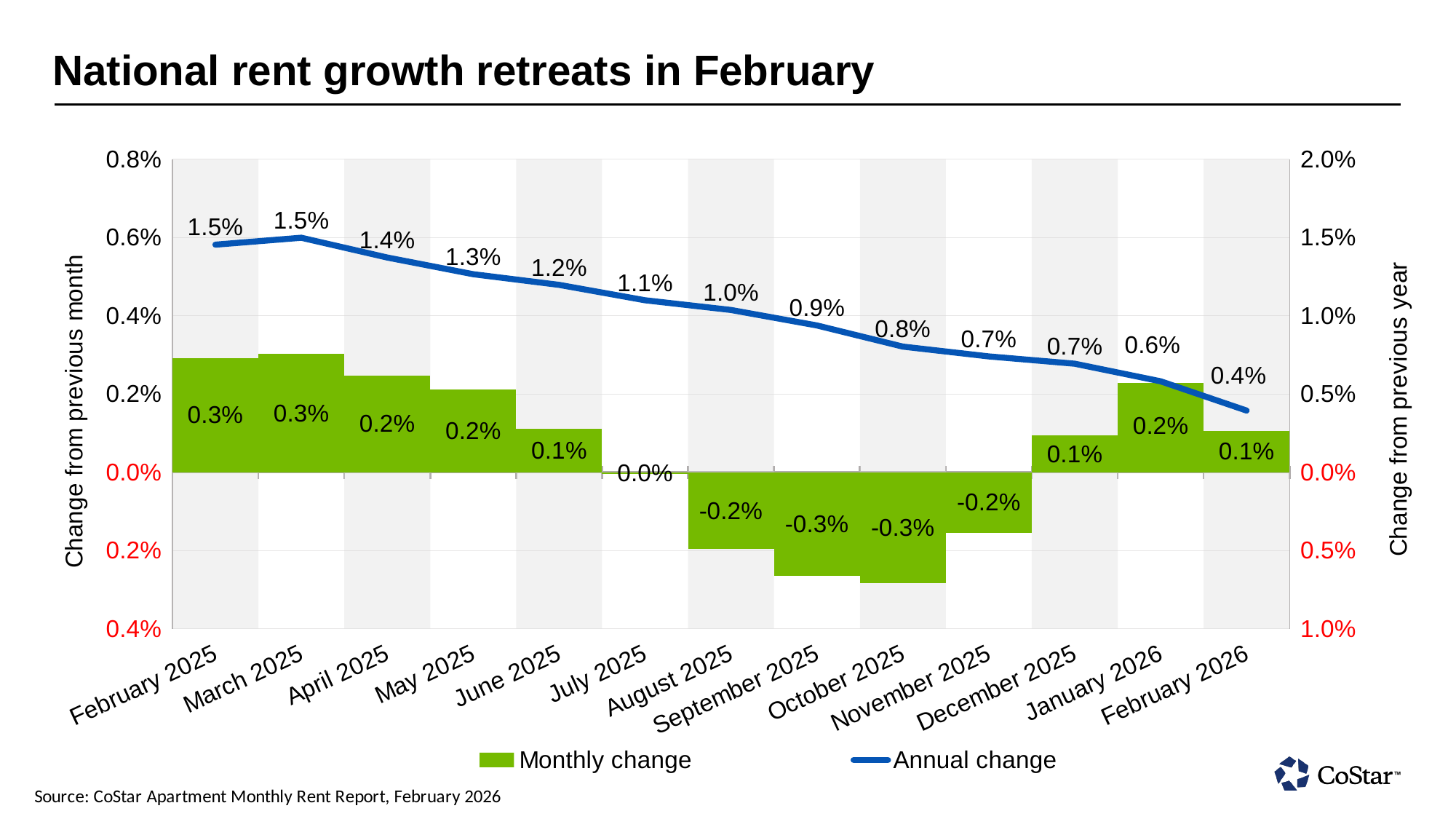
What colour are the monthly change bars? Green How many months are shown on the x axis? 13 What is the title of the chart? National rent growth retreats in February What is the annual change value for February 2026? 0.4% Which is larger, the monthly change for December 2025 or for January 2026? January 2026 What is the difference between the annual change in February 2025 and February 2026? 1.1% Which month has the lowest annual change value? February 2026 What is the monthly change value for January 2026? 0.2% What is the annual change value for July 2025? 1.1% How many series does the legend list? 2 What is the monthly change value for September 2025? -0.3% Does the annual change line rise or fall from February 2025 to February 2026? fall